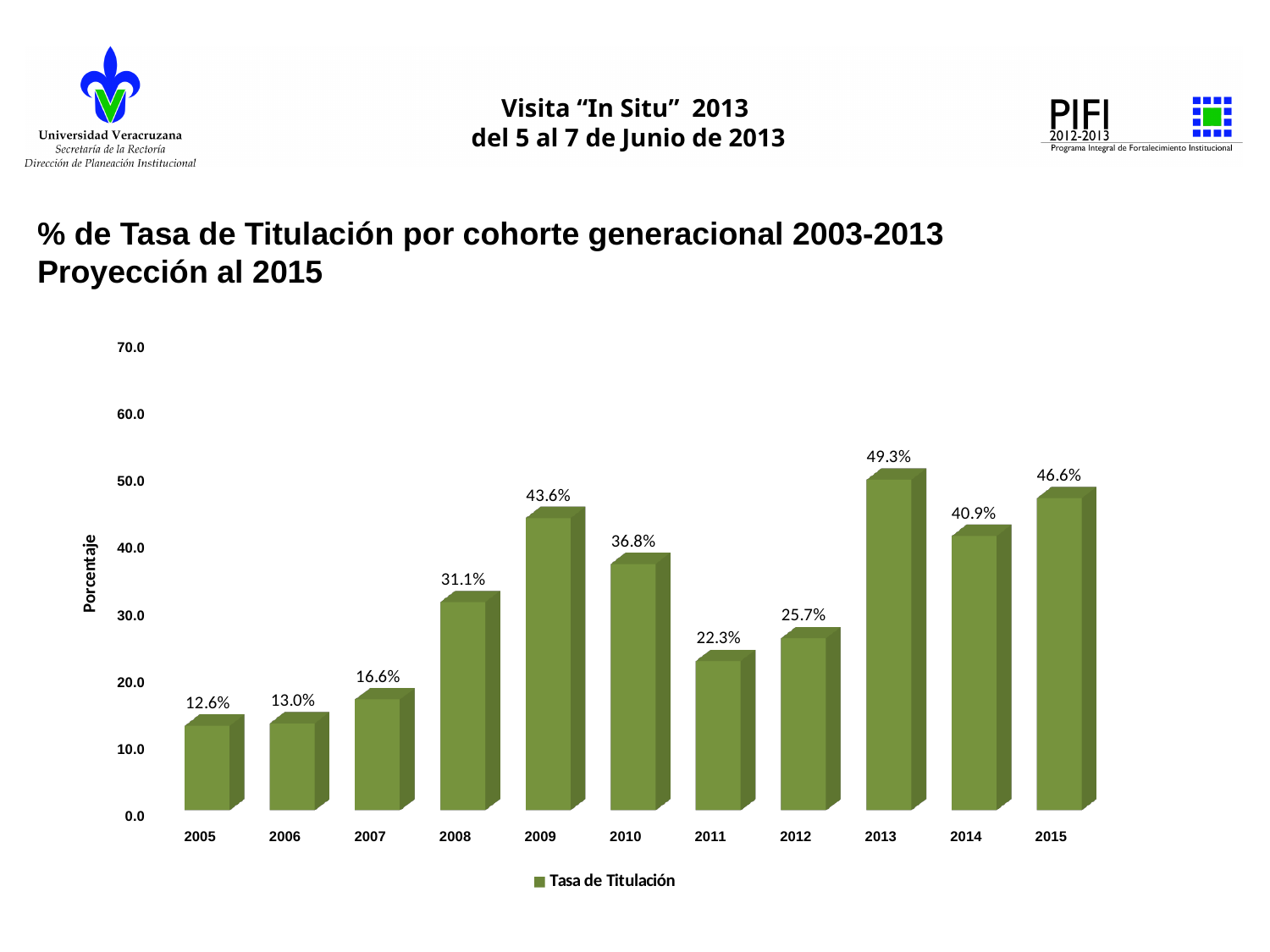
What is the Tasa de Titulación value for 2015? 46.6% How many series does the legend list? 1 What is the difference between the Tasa de Titulación values for 2013 and 2012? 23.6% Which year has a larger Tasa de Titulación, 2010 or 2014? 2014 What kind of chart is shown on the slide? bar chart How many years are shown on the x axis of the chart? 11 What is the Tasa de Titulación value for 2009? 43.6% What is the label of the y axis of the chart? Porcentaje Is the value for 2011 greater or less than 30.0? less Do the values rise or fall from 2005 to 2009? rise Which year has the highest Tasa de Titulación? 2013 Which year has the lowest Tasa de Titulación? 2005